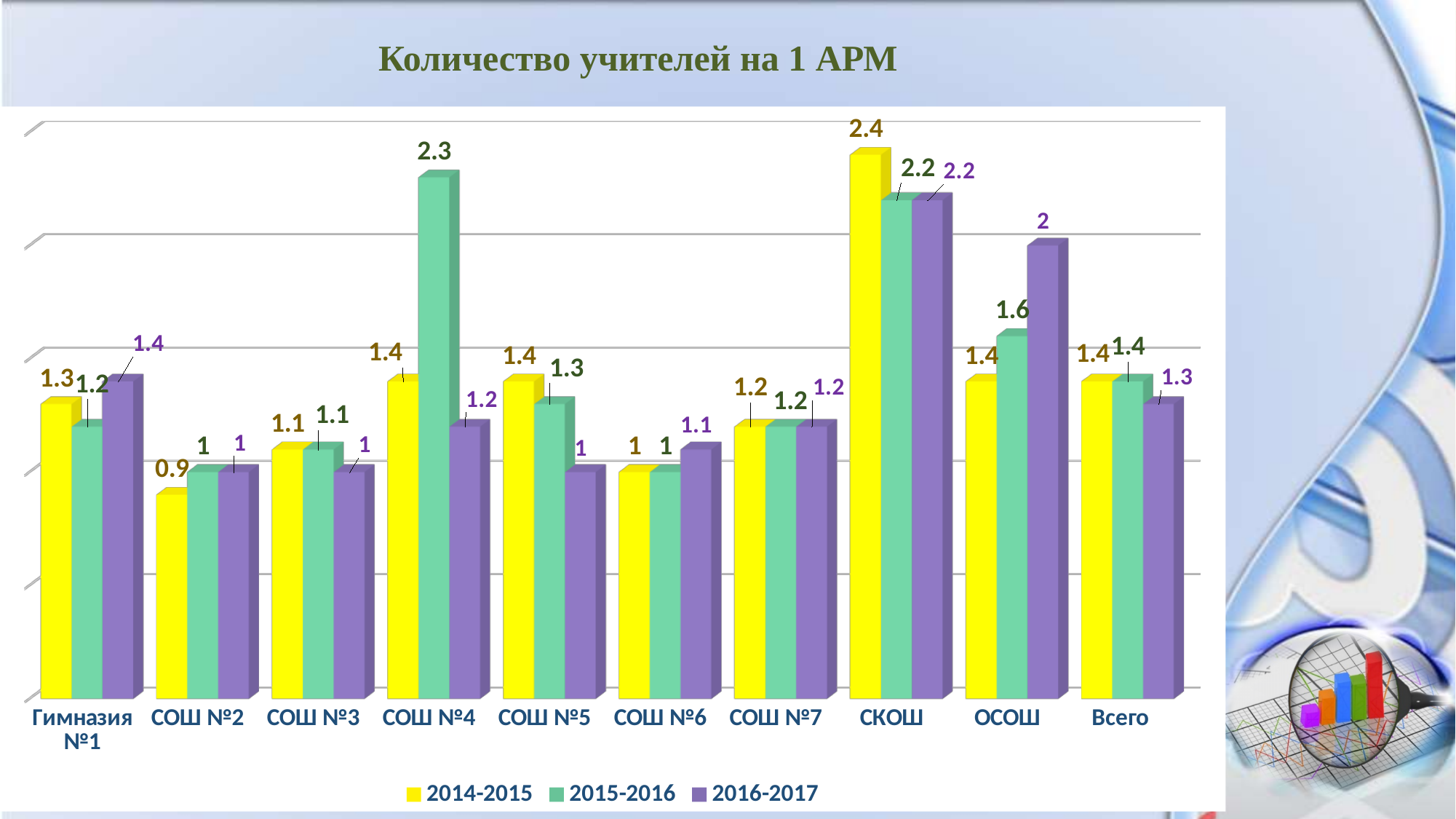
What is the title of the chart? Количество учителей на 1 АРМ What is the value for Всего in the 2016-2017 series? 1.3 Which category has the highest value in the 2014-2015 series? СКОШ What is the value for СОШ №4 in the 2015-2016 series? 2.3 Which is larger for ОСОШ: the 2014-2015 value or the 2016-2017 value? 2016-2017 What is the value for ОСОШ in the 2016-2017 series? 2 What is the difference between the 2015-2016 and 2016-2017 values for СОШ №4? 1.1 How many categories are shown on the x axis? 10 Which category has the lowest value in the 2014-2015 series? СОШ №2 How many series does the legend list? 3 What is the value for СКОШ in the 2014-2015 series? 2.4 What kind of chart is shown on the slide? Bar chart